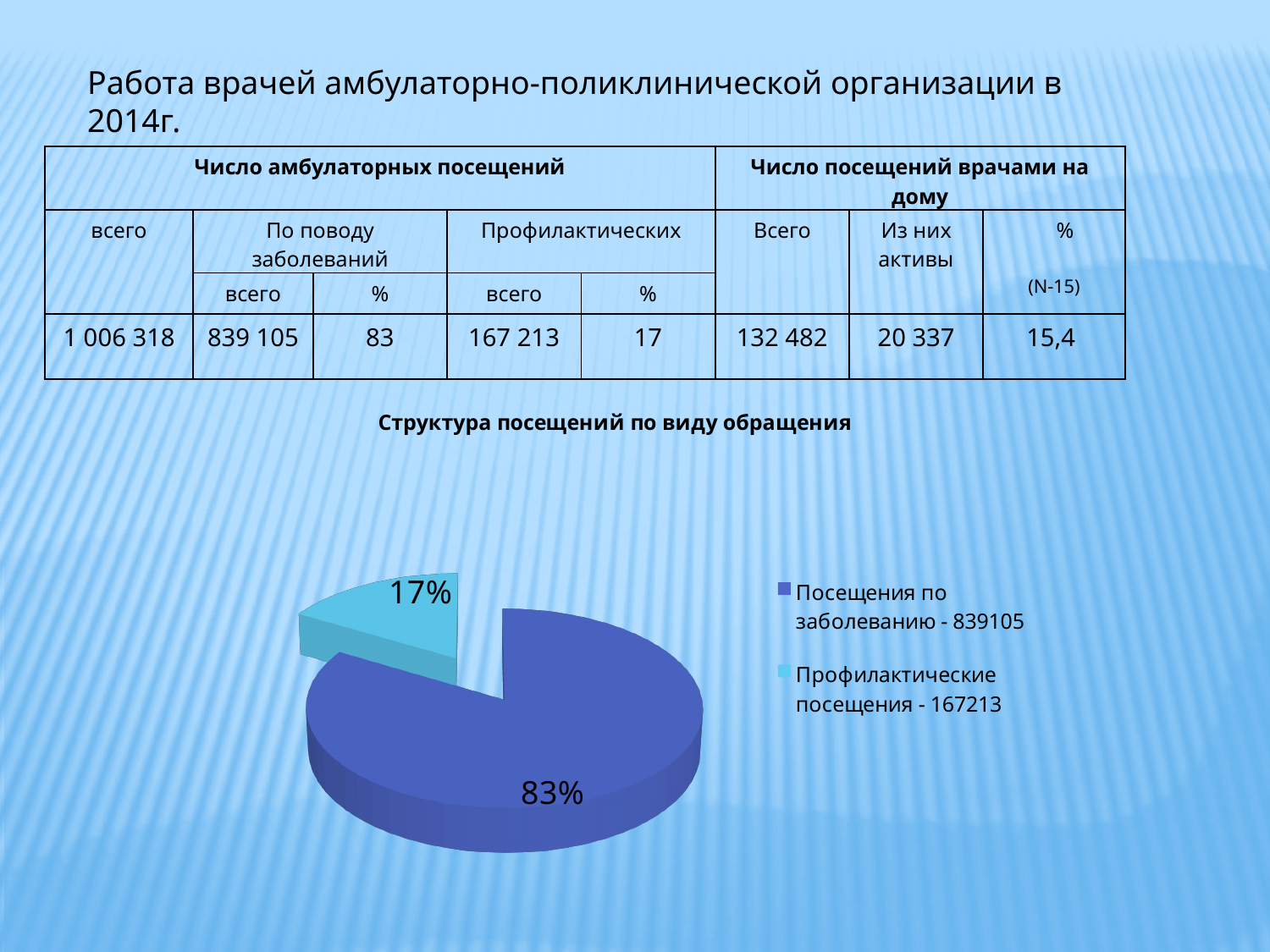
Which is larger in the pie chart: 'Посещения по заболеванию' or 'Профилактические посещения'? Посещения по заболеванию Which slice of the pie chart is the largest? Посещения по заболеванию What number is given in the legend for 'Посещения по заболеванию'? 839105 What number is given in the legend for 'Профилактические посещения'? 167213 What is the difference in percentage points between the two slices of the pie chart? 66 How many slices does the pie chart have? 2 How many entries does the chart legend list? 2 What share of the pie is labelled for 'Профилактические посещения'? 17% What share of the pie is labelled for 'Посещения по заболеванию'? 83% What kind of chart is shown on the slide? pie chart What is the title of the chart on the slide? Структура посещений по виду обращения Which slice of the pie chart is the smallest? Профилактические посещения